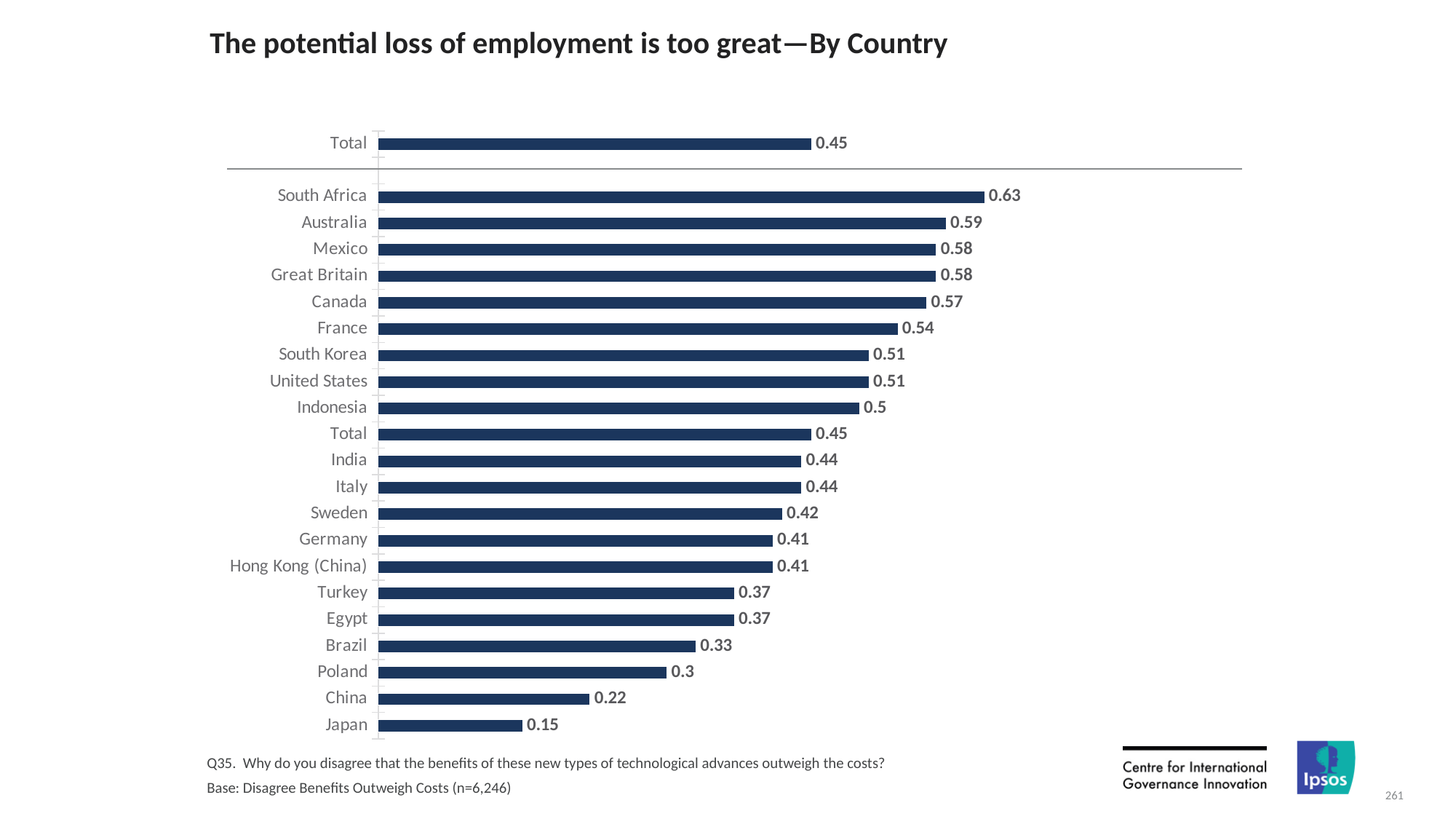
What type of chart is shown on the slide? Bar chart What is the value for Japan? 0.15 How many countries (excluding the Total bars) are shown in the chart? 20 What is the difference between the values for South Africa and Japan? 0.48 Which has a larger value, France or Germany? France What is the value shown for Total? 0.45 Which country has the highest value? South Africa What is the value for Canada? 0.57 What is the value for South Africa? 0.63 Which country has the lowest value? Japan Which has a larger value, China or Brazil? Brazil What is the difference between the values for Australia and Poland? 0.29